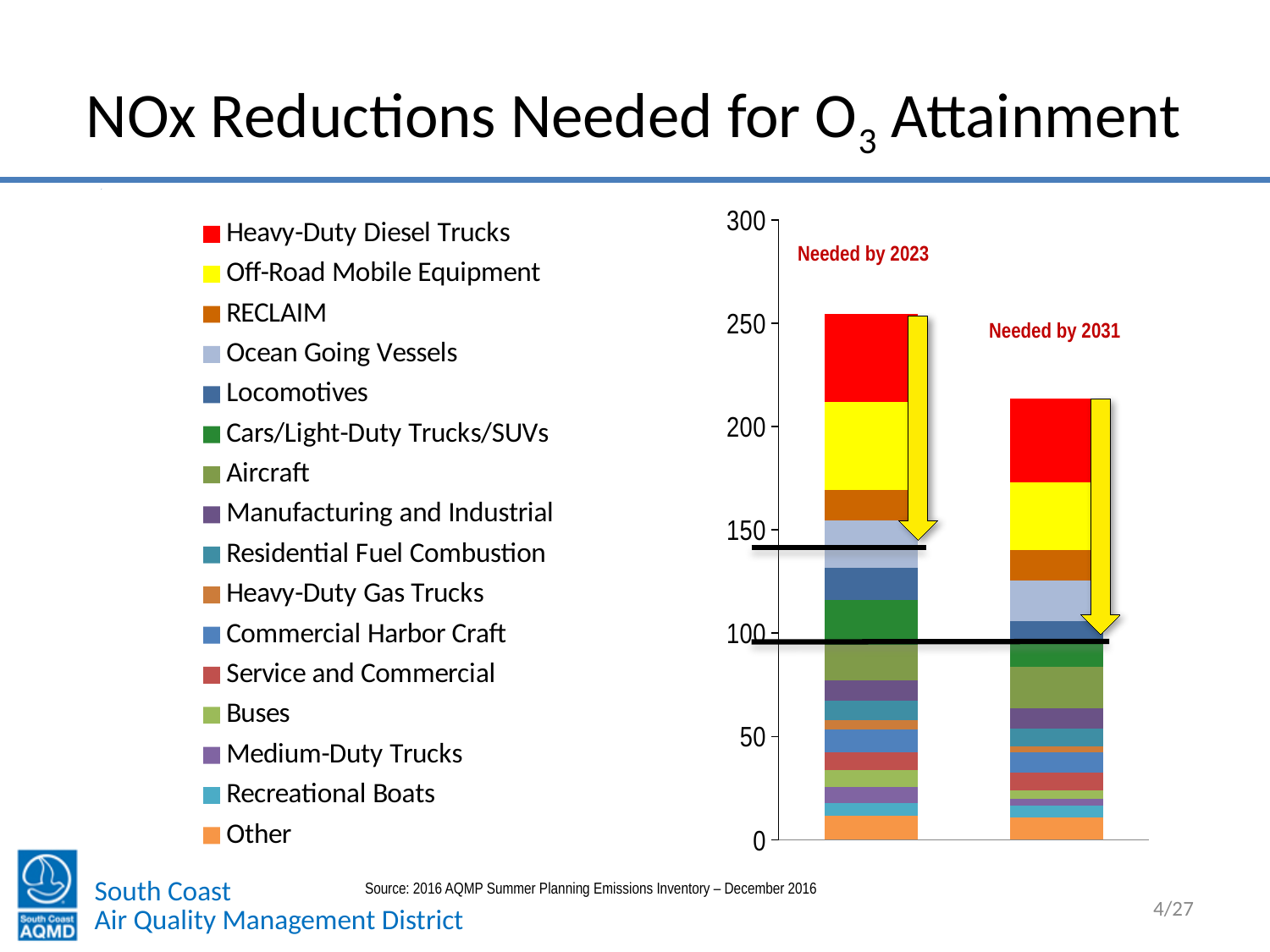
Is the total of the "Needed by 2023" bar greater or less than 150? greater Is the total of the "Needed by 2031" bar greater or less than 200? greater Which bar is taller, the one labelled "Needed by 2023" or the one labelled "Needed by 2031"? Needed by 2023 Which series forms the top (red) segment of each stacked bar? Heavy-Duty Diesel Trucks What is the title of the slide containing the chart? NOx Reductions Needed for O3 Attainment How many series does the legend list? 16 Is the total of the "Needed by 2023" bar greater or less than 200? greater What is the highest value shown on the vertical axis? 300 What kind of chart is shown on the slide? stacked bar chart Do the bar totals rise or fall from the "Needed by 2023" bar to the "Needed by 2031" bar? fall How many stacked bars are plotted in the chart? 2